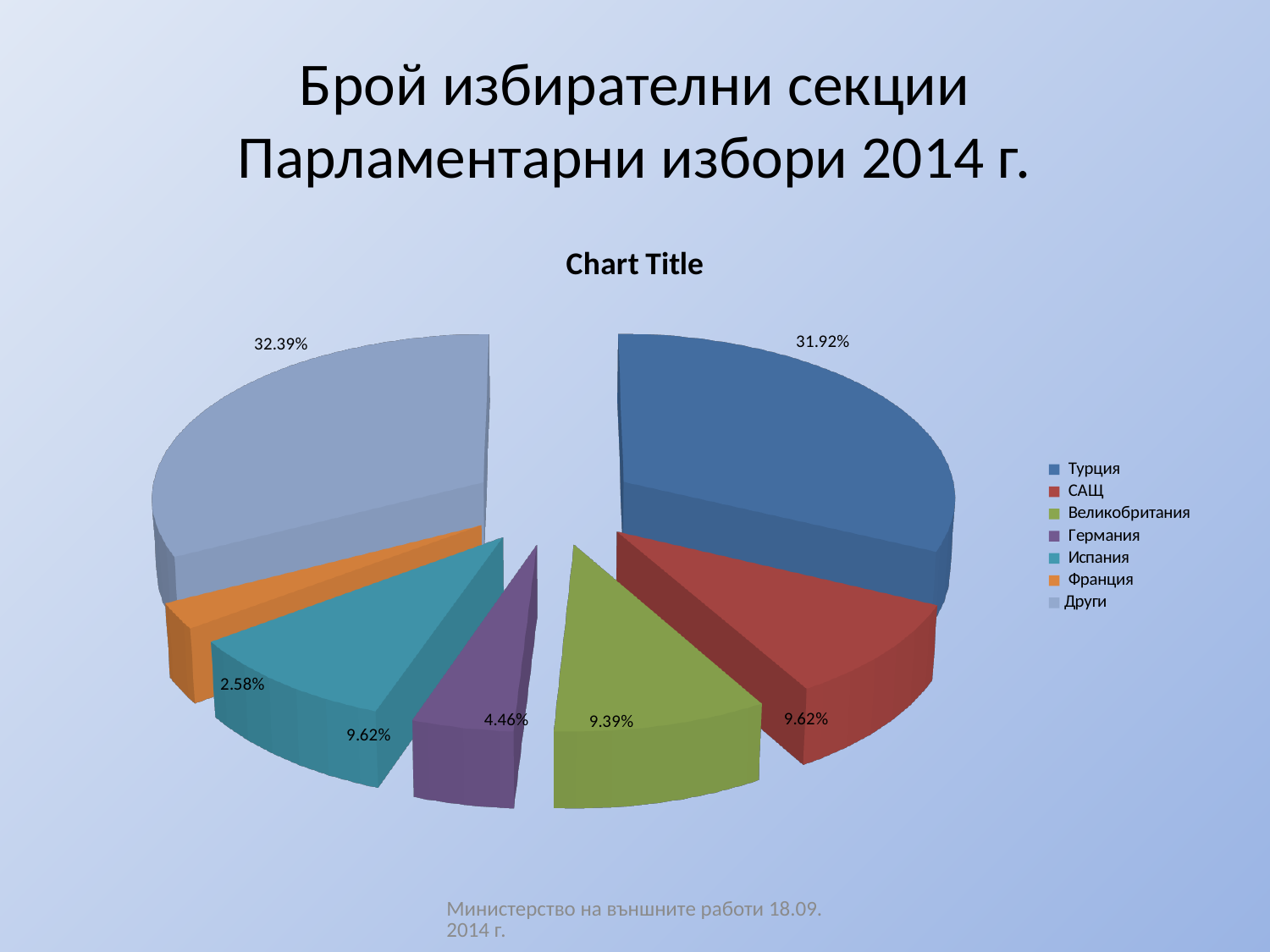
What share of the pie does Други hold? 32.39% What is the value shown for Франция? 2.58% What is the value shown for Германия? 4.46% How many categories does the pie chart have? 7 Which category has the smallest share of the pie? Франция What is the difference between the shares of Други and Турция? 0.47% What kind of chart is shown on the slide? pie chart What is the value shown for Великобритания? 9.39% Which is larger, the share for Турция or the share for САЩ? Турция What share of the pie does Турция hold? 31.92% What is the title printed above the pie chart? Chart Title Which category has the largest share of the pie? Други